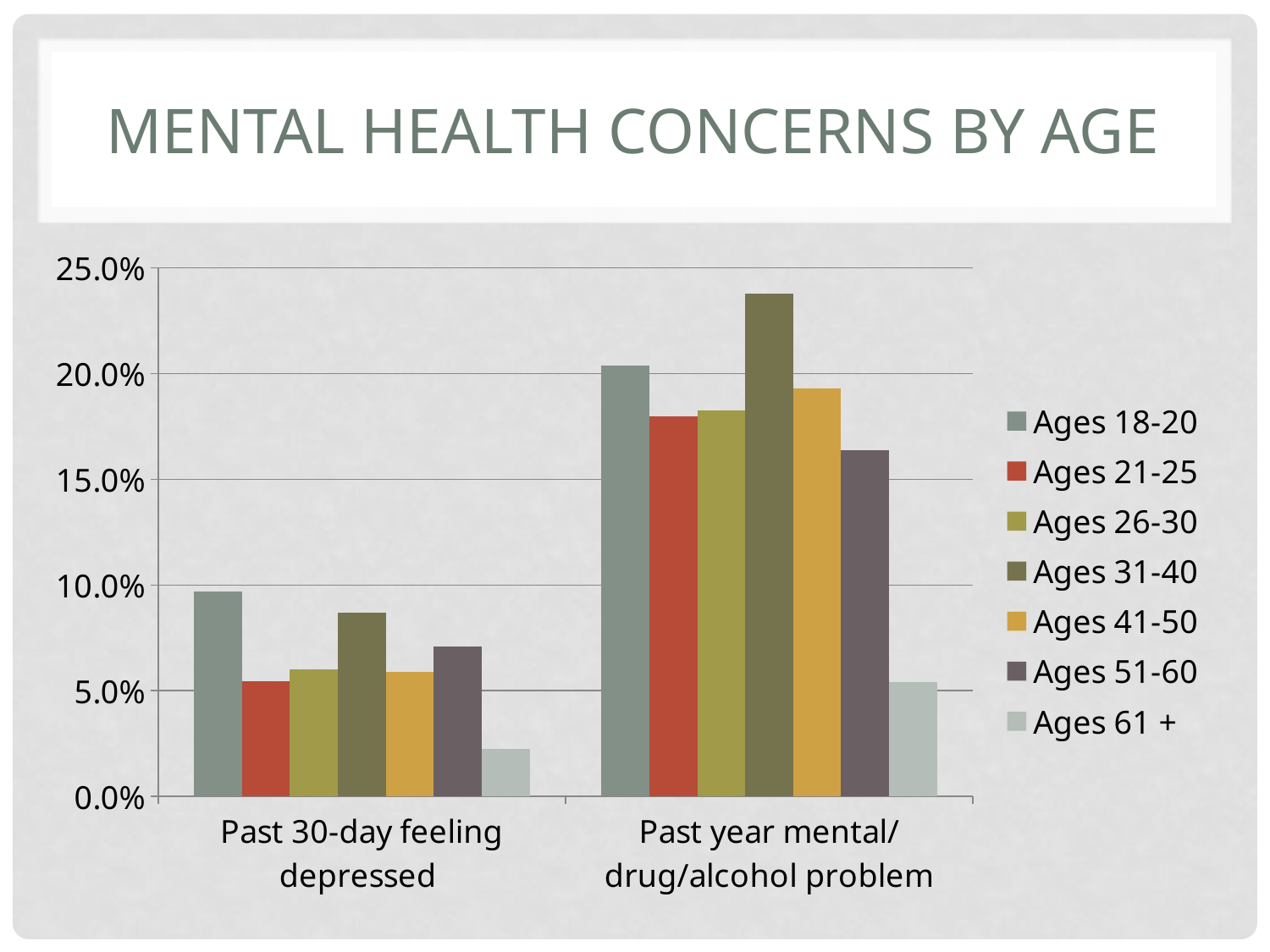
In Past year mental/drug/alcohol problem, which is larger: Ages 18-20 or Ages 21-25? Ages 18-20 How many categories are shown on the x axis? 2 Which age group has the lowest value for Past 30-day feeling depressed? Ages 61 + Is the value for Ages 51-60 in Past year mental/drug/alcohol problem greater or less than 20.0%? less Which age group has the highest value for Past year mental/drug/alcohol problem? Ages 31-40 Which age group has the highest value for Past 30-day feeling depressed? Ages 18-20 Is the value for Ages 31-40 in Past year mental/drug/alcohol problem greater or less than 20.0%? greater What is the title of the slide? Mental Health Concerns by Age What kind of chart is shown on the slide? Bar chart How many age groups does the legend list? 7 Is the value for Ages 61 + in Past 30-day feeling depressed greater or less than 5.0%? less Which age group has the lowest value for Past year mental/drug/alcohol problem? Ages 61 +